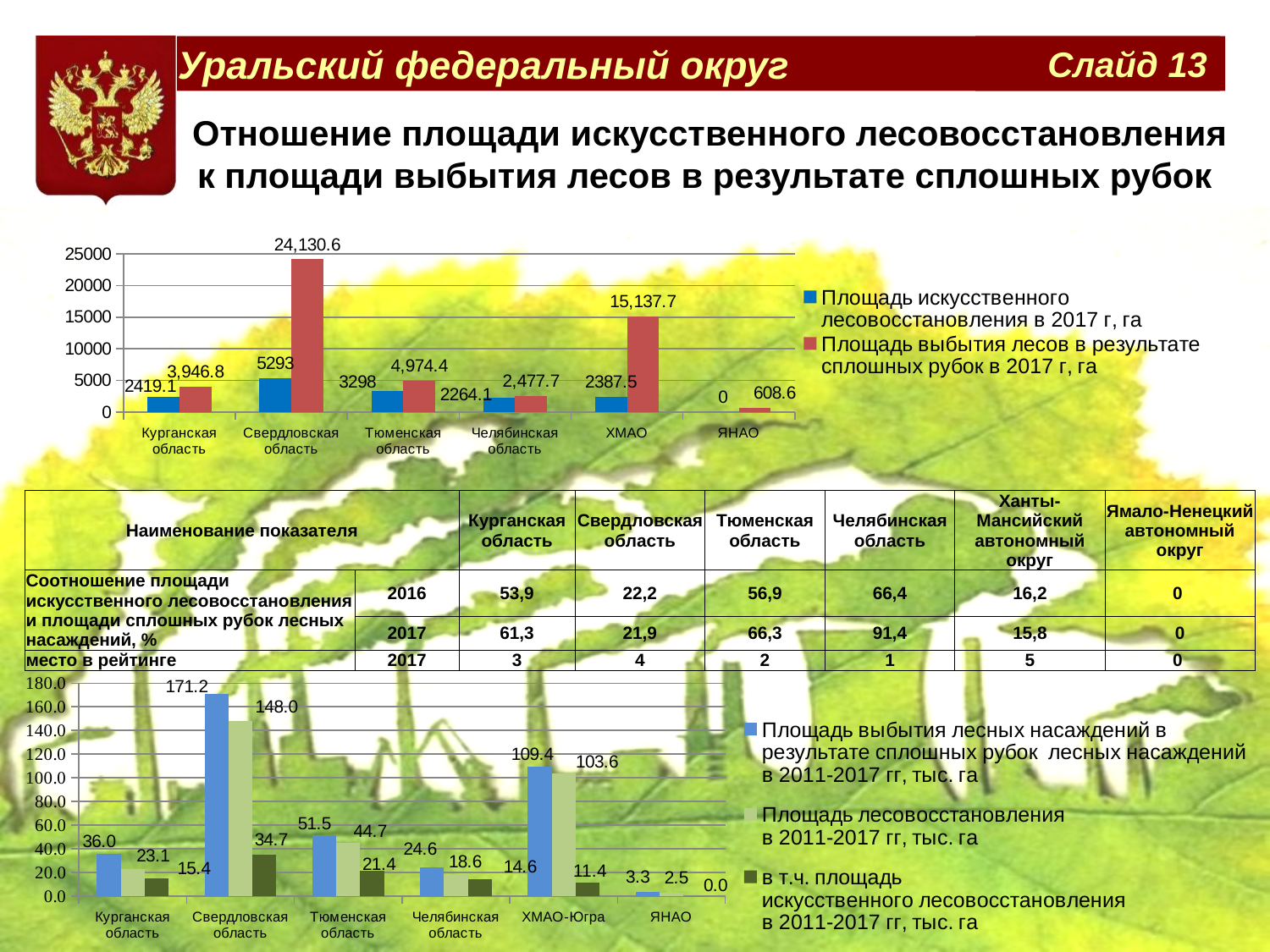
In the top chart, what is the value of 'Площадь выбытия лесов в результате сплошных рубок в 2017 г, га' for Свердловская область? 24,130.6 In the bottom chart, what is the value of 'Площадь выбытия лесных насаждений в результате сплошных рубок лесных насаждений в 2011-2017 гг, тыс. га' for Свердловская область? 171.2 In the bottom chart, which category has the highest value for 'Площадь лесовосстановления в 2011-2017 гг, тыс. га'? Свердловская область In the bottom chart, how many series does the legend list? 3 In the top chart, is the value of 'Площадь выбытия лесов в результате сплошных рубок в 2017 г, га' for ХМАО greater or less than 10000? greater In the top chart, how many series does the legend list? 2 In the top chart, what is the value of 'Площадь искусственного лесовосстановления в 2017 г, га' for Тюменская область? 3298 What type of chart is the bottom chart? bar chart In the top chart, which category has the highest value for 'Площадь выбытия лесов в результате сплошных рубок в 2017 г, га'? Свердловская область In the bottom chart, what is the value of 'в т.ч. площадь искусственного лесовосстановления в 2011-2017 гг, тыс. га' for Тюменская область? 21.4 In the bottom chart, what is the difference between 'Площадь выбытия лесных насаждений в результате сплошных рубок лесных насаждений в 2011-2017 гг, тыс. га' and 'Площадь лесовосстановления в 2011-2017 гг, тыс. га' for Курганская область? 12.9 In the top chart, which category has the lowest value for 'Площадь искусственного лесовосстановления в 2017 г, га'? ЯНАО